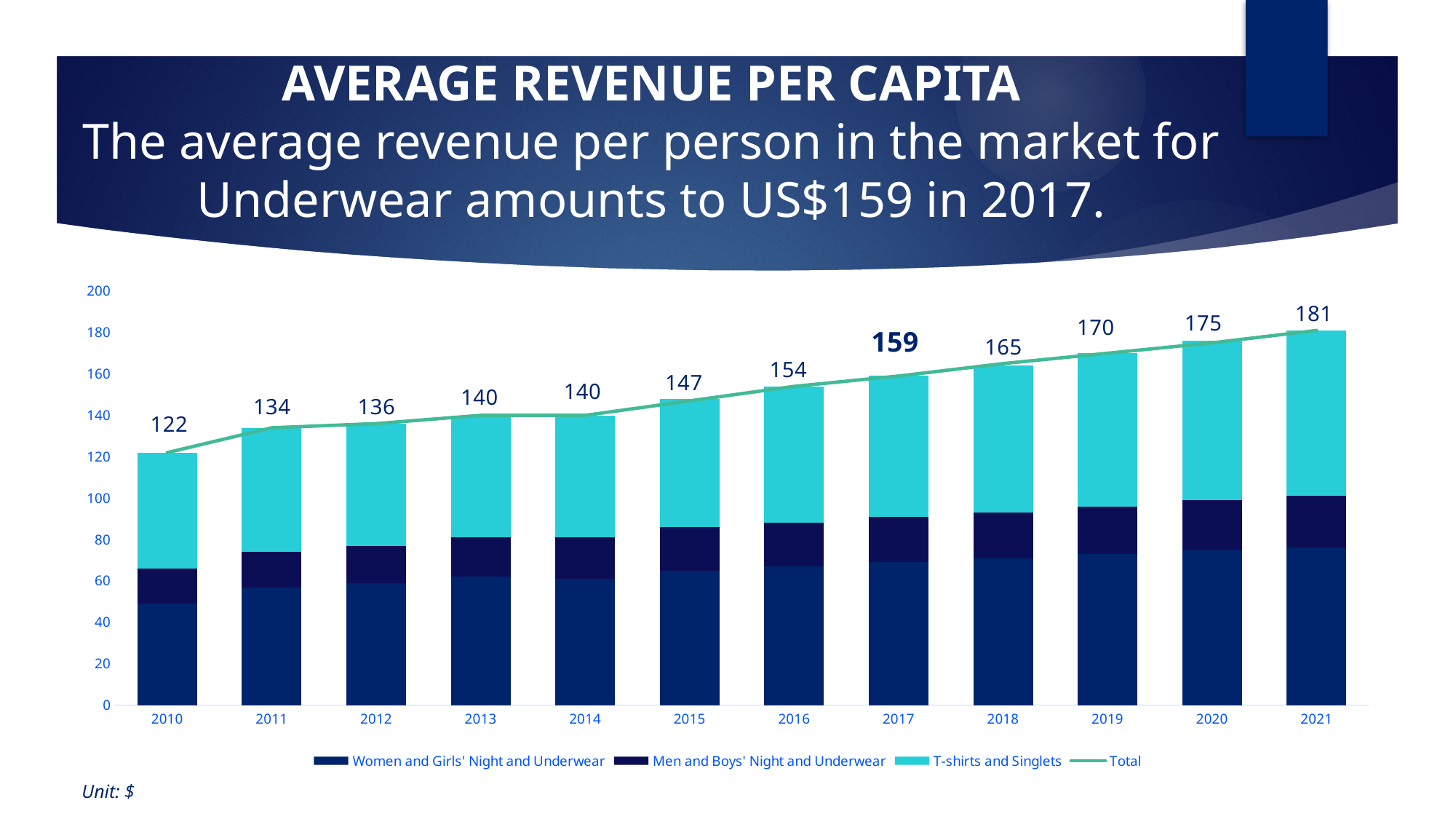
How many entries does the legend list? 4 What is the total value labelled for 2010? 122 Is the value for Women and Girls' Night and Underwear in 2021 greater or less than 60? greater Do the total values rise or fall from 2010 to 2021? rise Which year has the highest total average revenue per capita? 2021 What is the difference between the total for 2021 and the total for 2010? 59 What is the total value labelled for 2021? 181 How many years are shown on the x axis? 12 Which year has the lowest total average revenue per capita? 2010 What is the total average revenue per capita shown for 2017? 159 Which year has a larger total, 2015 or 2019? 2019 What is the difference between the total for 2018 and the total for 2017? 6